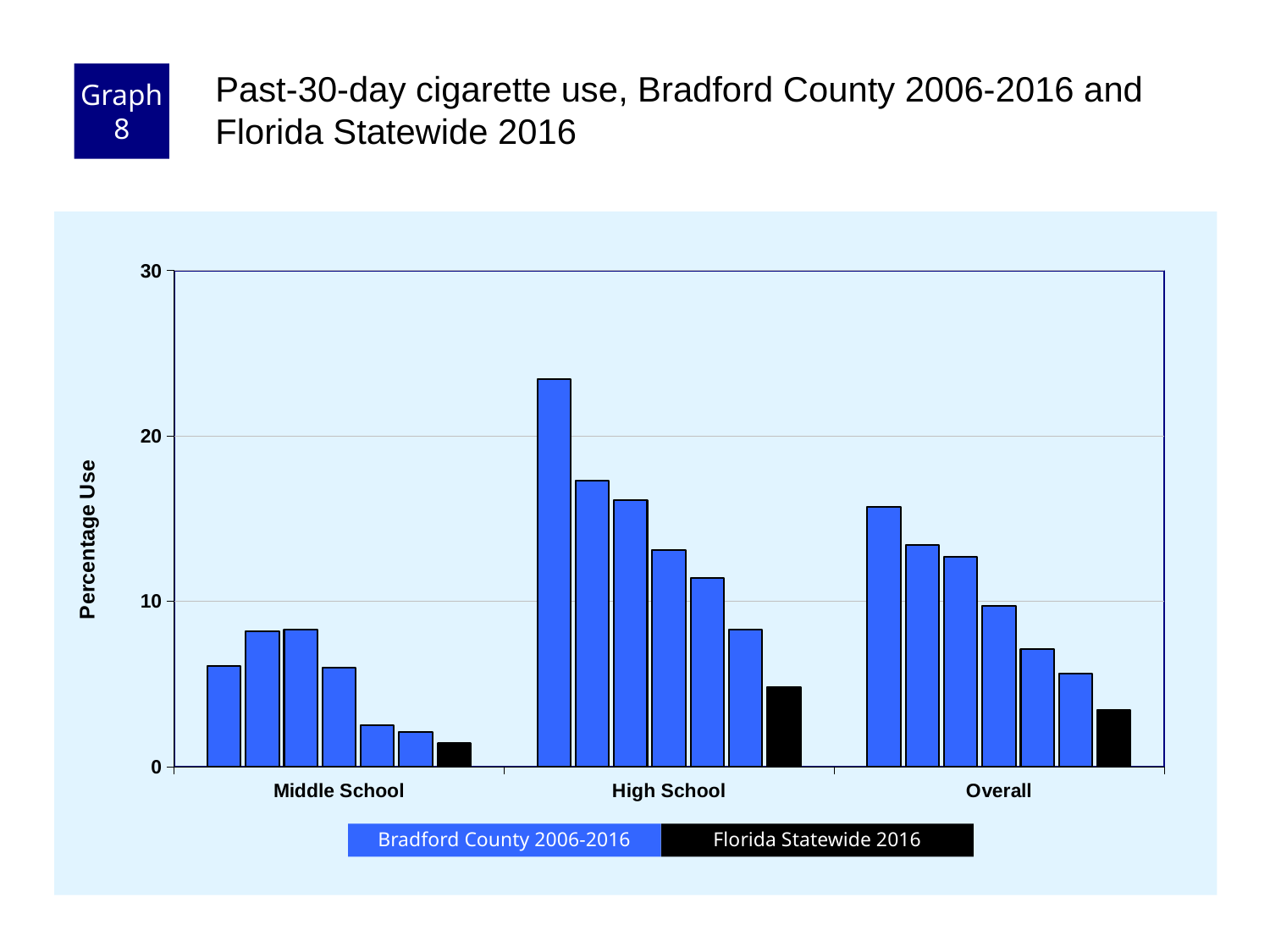
Is the value for the tallest Middle School bar greater or less than 10? less Is the Florida Statewide 2016 value for High School greater or less than 10? less Which is larger: the Florida Statewide 2016 bar for High School or for Overall? High School Which school-level category has the lowest Florida Statewide 2016 bar? Middle School How many series does the legend list? 2 Which school-level category has the highest bar? High School What kind of chart is shown on the slide? bar chart Is the value for the tallest High School bar greater or less than 20? greater How many school-level categories are shown on the x axis? 3 What is the label on the y axis? Percentage Use Within the High School group, do the Bradford County bars rise or fall from left to right? fall